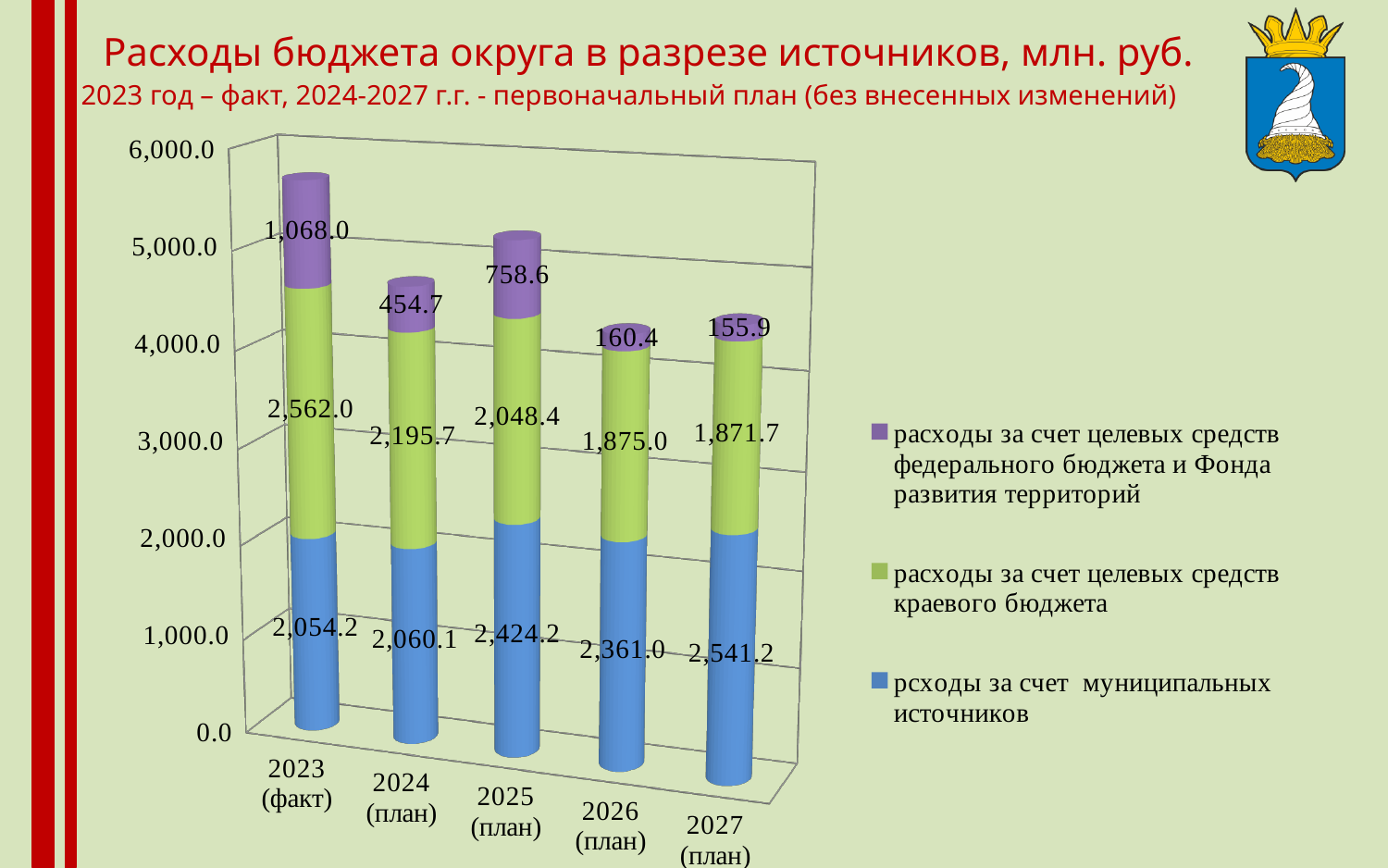
What is the difference between the 'расходы за счет целевых средств краевого бюджета' values for 2023 (факт) and 2024 (план)? 366.3 How many series does the legend list? 3 What is the value for 'расходы за счет целевых средств федерального бюджета и Фонда развития территорий' in 2023 (факт)? 1,068.0 What is the value for 'расходы за счет целевых средств краевого бюджета' in 2025 (план)? 2,048.4 Is the total of the stacked bar for 2023 (факт) greater or less than 5,000.0? greater How many years (categories) are shown on the x axis? 5 In which year is the value for 'расходы за счет целевых средств федерального бюджета и Фонда развития территорий' the lowest? 2027 (план) What kind of chart is shown on the slide? Stacked bar chart What is the total of the stacked bar for 2024 (план)? 4,710.5 What is the value for 'рсходы за счет муниципальных источников' in 2027 (план)? 2,541.2 In which year is the value for 'рсходы за счет муниципальных источников' the highest? 2027 (план) Which is larger: 'рсходы за счет муниципальных источников' in 2025 (план) or in 2026 (план)? 2025 (план)